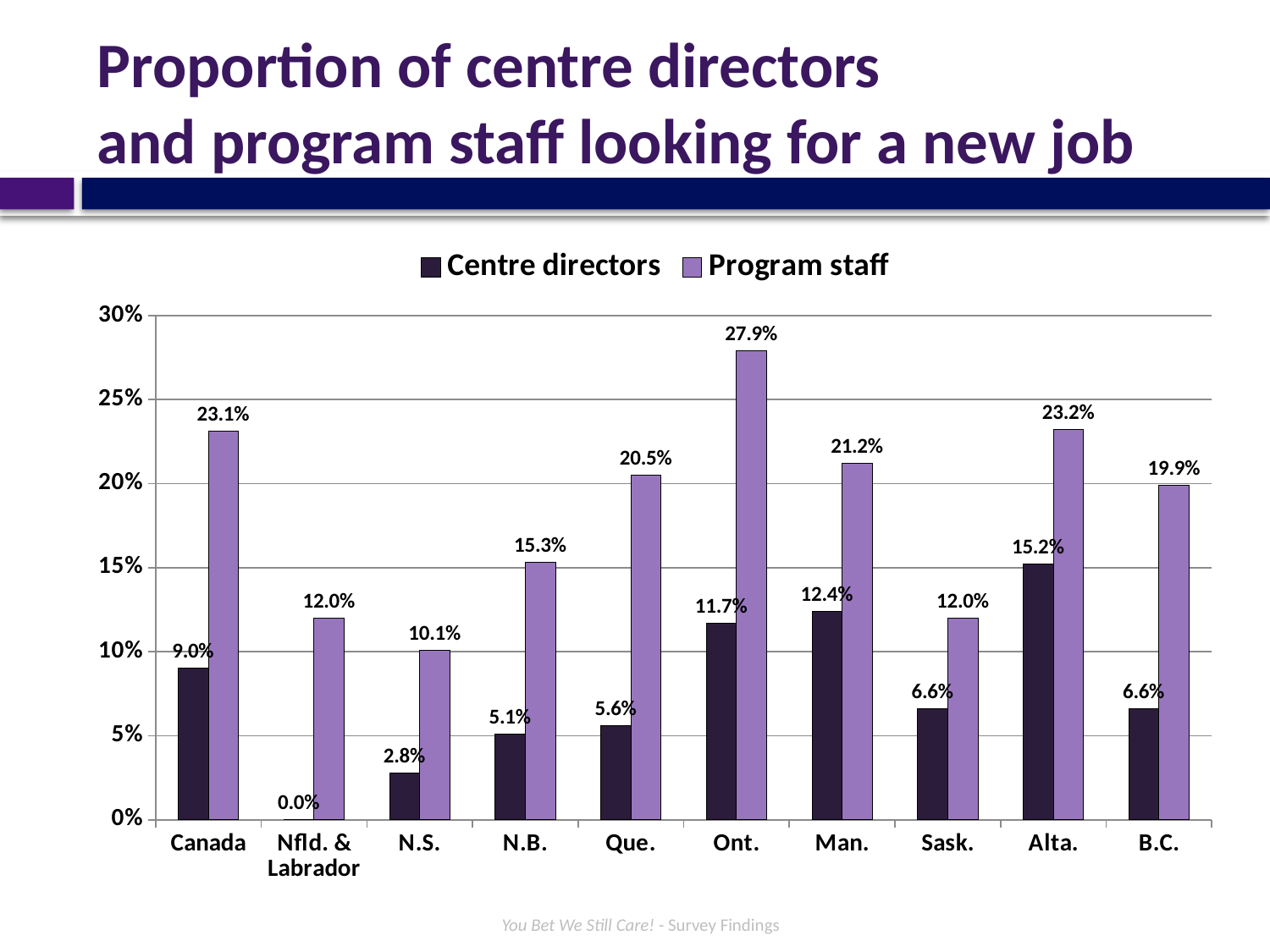
What is the value for Centre directors in Alta.? 15.2% Is the Program staff value for Alta. greater or less than 20%? greater Which category has the lowest Centre directors value? Nfld. & Labrador What is the difference between the Program staff and Centre directors values for Canada? 14.1% Which category has the highest Program staff value? Ont. Which is larger in Man.: the Centre directors value or the Program staff value? Program staff How many series does the legend list? 2 What are the two series listed in the legend? Centre directors and Program staff What is the value for Centre directors in Nfld. & Labrador? 0.0% What is the value for Program staff in Ont.? 27.9% How many categories are shown on the x axis? 10 What kind of chart is shown on the slide? Bar chart